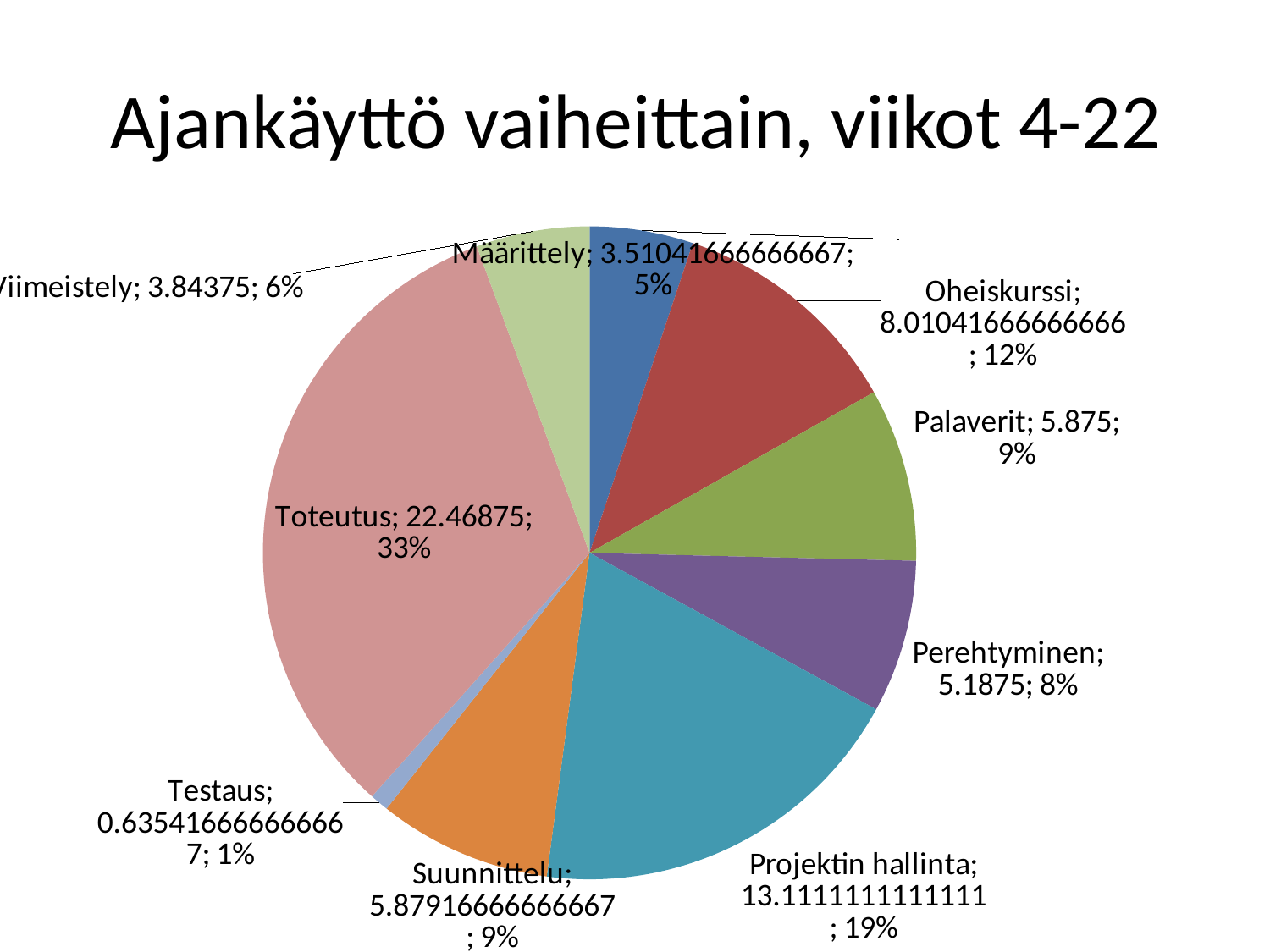
What is the value shown for Palaverit? 5.875 What is the value shown for Toteutus? 22.46875 Which category has the largest slice of the pie? Toteutus What is the difference between the values for Toteutus and Viimeistely? 18.625 How many slices does the pie chart have? 9 Which category has the smallest slice of the pie? Testaus What is the value shown for Perehtyminen? 5.1875 What is the title of the chart? Ajankäyttö vaiheittain, viikot 4-22 What kind of chart is shown on the slide? pie chart Which is larger, the value for Oheiskurssi or the value for Palaverit? Oheiskurssi What share of the pie does Toteutus represent? 33% What share of the pie does Projektin hallinta represent? 19%